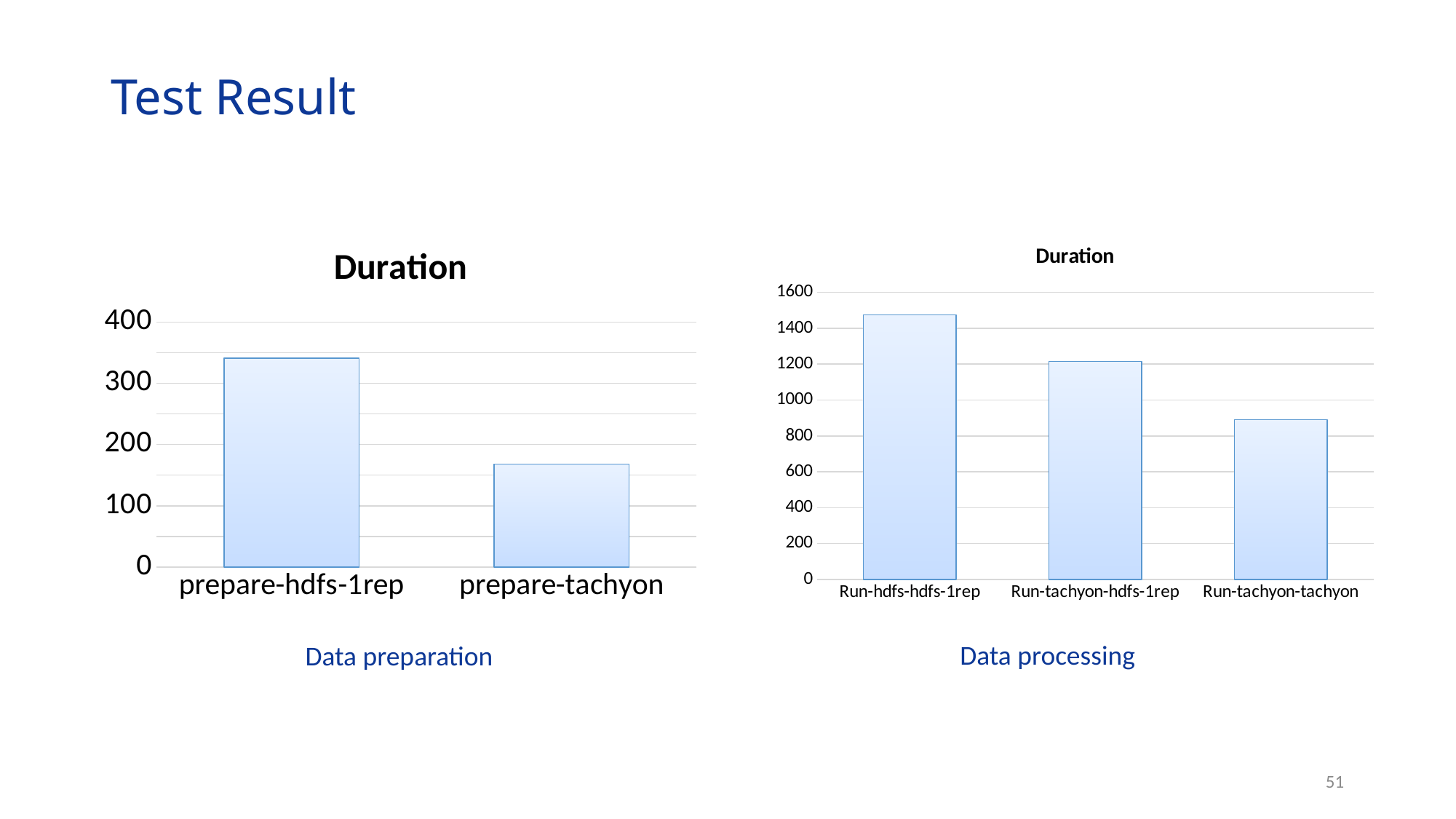
In the Data preparation chart on the left, how many categories are plotted? 2 In the Data processing chart on the right, which is larger: Run-tachyon-hdfs-1rep or Run-tachyon-tachyon? Run-tachyon-hdfs-1rep In the Data processing chart on the right, which category has the lowest duration? Run-tachyon-tachyon In the Data preparation chart on the left, is the value for prepare-hdfs-1rep greater or less than 300? greater In the Data processing chart on the right, do the values rise or fall from left to right along the x axis? fall In the Data processing chart on the right, which category has the highest duration? Run-hdfs-hdfs-1rep In the Data processing chart on the right, is the value for Run-tachyon-hdfs-1rep greater or less than 1000? greater In the Data preparation chart on the left, what is the chart title? Duration In the Data preparation chart on the left, is the value for prepare-tachyon greater or less than 200? less In the Data processing chart on the right, how many categories are plotted? 3 In the Data preparation chart on the left, which category has the highest duration? prepare-hdfs-1rep In the Data preparation chart on the left, what kind of chart is shown? bar chart